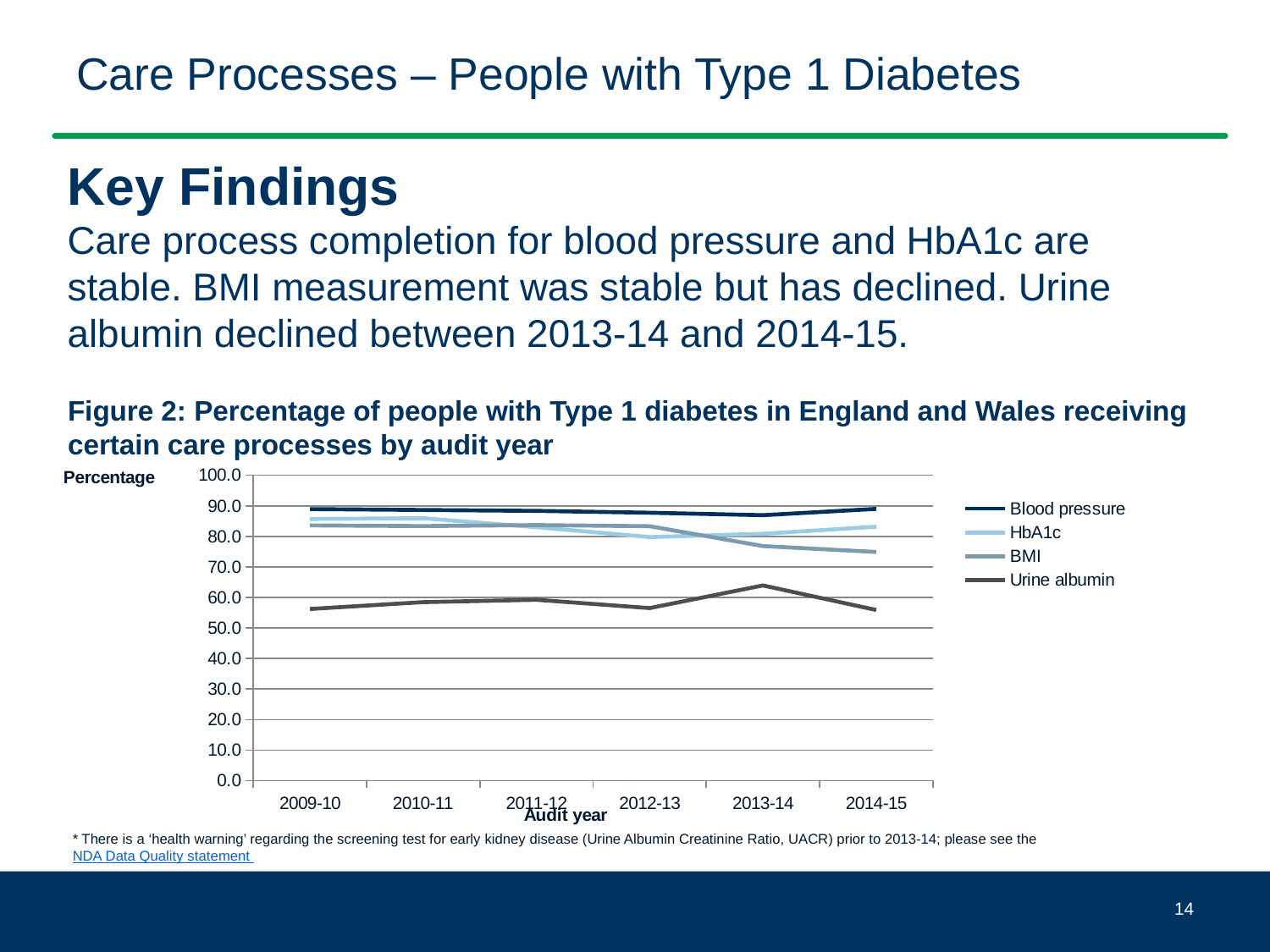
Is the value for Blood pressure in 2009-10 greater or less than 80.0? greater How many series does the legend of Figure 2 list? 4 In 2014-15, which is higher: HbA1c or BMI? HbA1c Which series has the highest value in 2014-15? Blood pressure In which audit year is the Urine albumin value highest? 2013-14 Which series has the lowest value in 2014-15? Urine albumin What is the title of the x axis in Figure 2? Audit year Is the value for Urine albumin in 2013-14 greater or less than 60.0? greater Does the BMI series rise or fall from 2009-10 to 2014-15? fall How many audit years are shown on the x axis of Figure 2? 6 What kind of chart is Figure 2? line chart Is the value for BMI in 2014-15 greater or less than 80.0? less